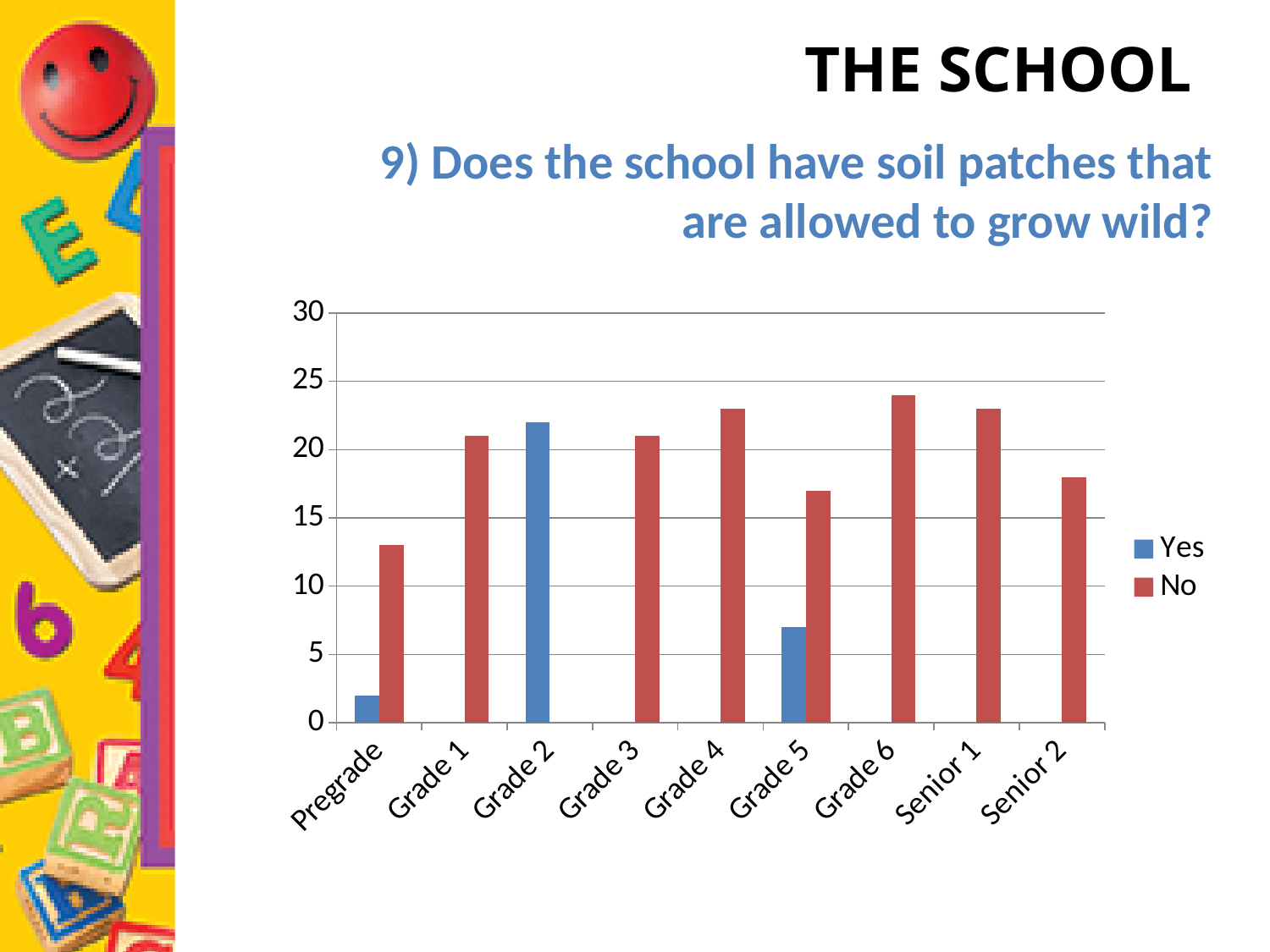
Which category has the highest 'Yes' value? Grade 2 Is the 'No' value for Senior 2 greater or less than 20? less Which category has the lowest 'No' value? Grade 2 What kind of chart is shown on the slide? bar chart Which is larger, the 'Yes' value for Grade 2 or the 'No' value for Senior 2? Yes value for Grade 2 Is the 'Yes' value for Grade 5 greater or less than 10? less Is the 'No' value for Pregrade greater or less than 15? less How many series does the legend list? 2 How many grade categories are shown on the x axis? 9 For Grade 5, which is larger, the 'Yes' value or the 'No' value? No What colour represents the 'No' series in the chart? red